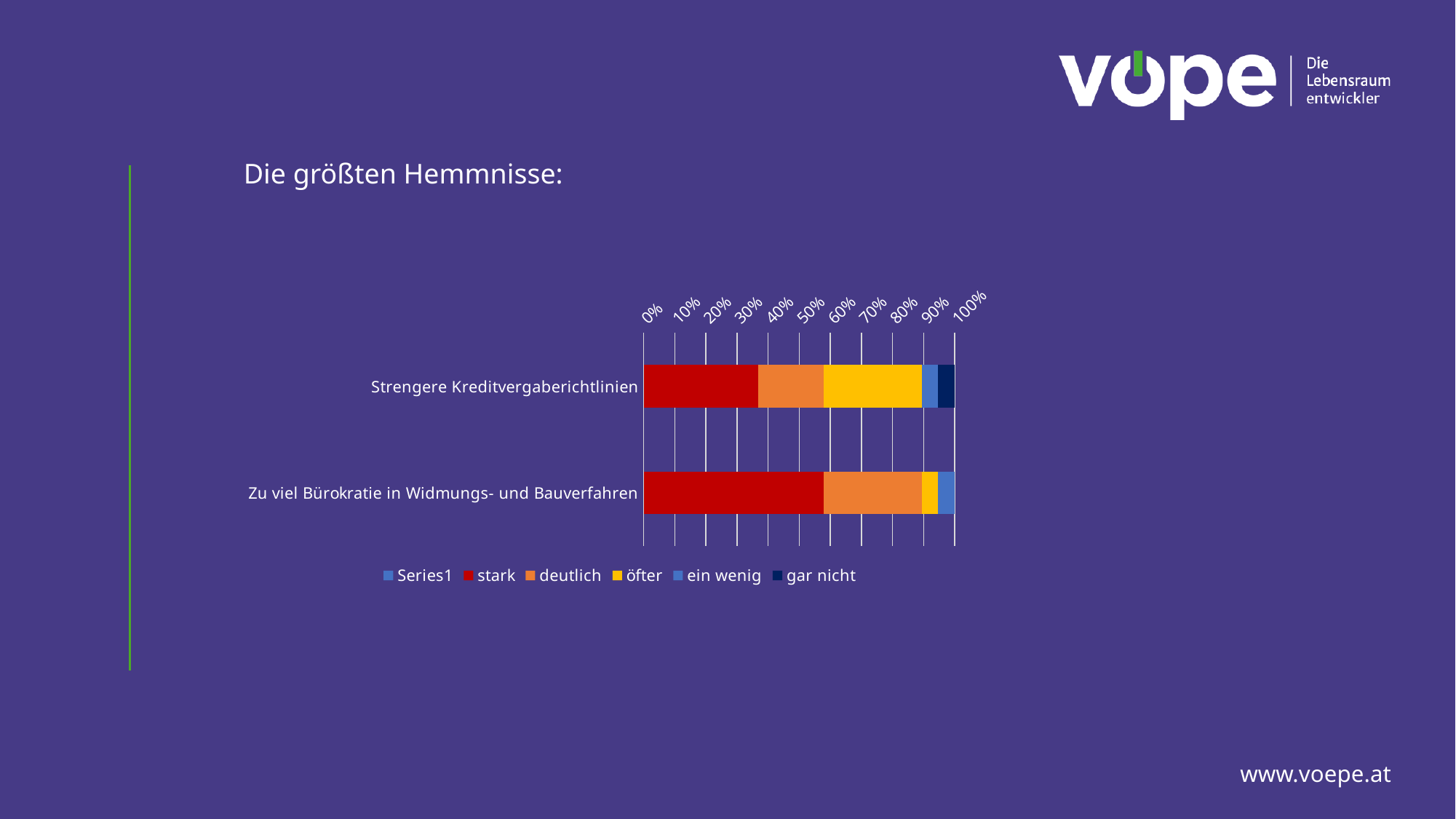
What kind of chart is shown on the slide? bar chart Is the "stark" segment for "Zu viel Bürokratie in Widmungs- und Bauverfahren" greater or less than 50%? greater Which series has the largest segment in the bar for "Zu viel Bürokratie in Widmungs- und Bauverfahren"? stark Is the "stark" segment for "Strengere Kreditvergaberichtlinien" greater or less than 50%? less What is the title of the chart? Die größten Hemmnisse: How many categories are plotted on the chart? 2 Which colour represents the series "stark" in the chart? red Which category has the larger "stark" segment? Zu viel Bürokratie in Widmungs- und Bauverfahren Which category has the larger "deutlich" segment? Zu viel Bürokratie in Widmungs- und Bauverfahren Is the "stark" segment for "Strengere Kreditvergaberichtlinien" greater or less than 30%? greater How many series does the legend list? 6 Which category has the larger "öfter" segment? Strengere Kreditvergaberichtlinien